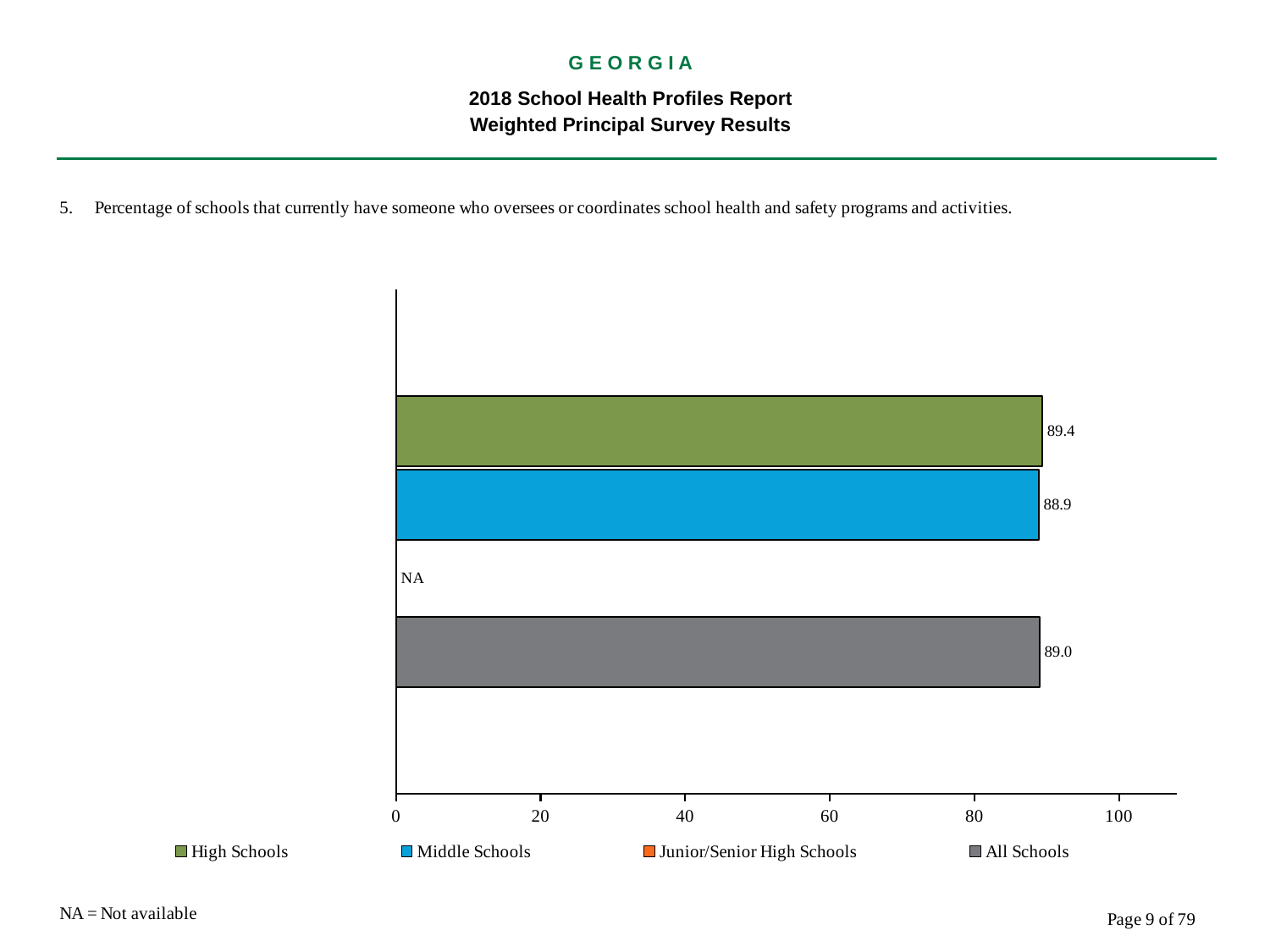
What is the difference between the High Schools value and the Middle Schools value? 0.5 What kind of chart is this? bar chart Is the value for All Schools greater or less than 80? greater How many series does the legend list? 4 Which school type has the highest value? High Schools Among the school types with a plotted value, which has the lowest value? Middle Schools What does NA stand for according to the note on the slide? Not available What is the difference between the All Schools value and the Middle Schools value? 0.1 What is shown for Junior/Senior High Schools? NA What is the value for All Schools? 89.0 What is the value for Middle Schools? 88.9 What is the value for High Schools? 89.4